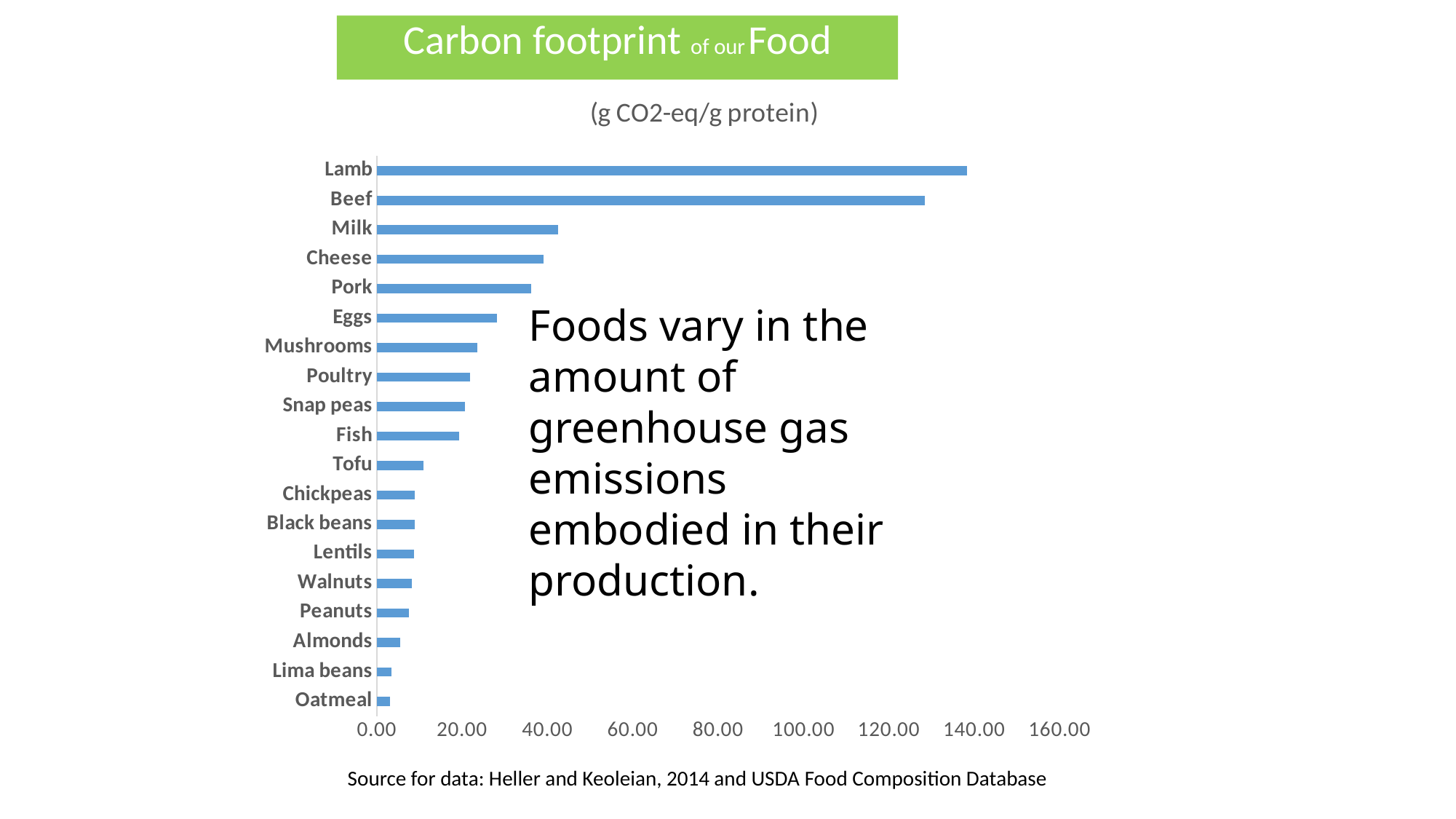
Is the value for Eggs greater or less than 20.00? greater Is the value for Pork greater or less than 40.00? less Which has the larger carbon footprint, Milk or Pork? Milk Is the value for Lamb greater or less than 120.00? greater What unit is given for the values in the chart? g CO2-eq/g protein Which food has the highest carbon footprint in the chart? Lamb What kind of chart is shown on the slide? bar chart How many food categories are plotted in the chart? 19 Which has the larger carbon footprint, Lamb or Beef? Lamb